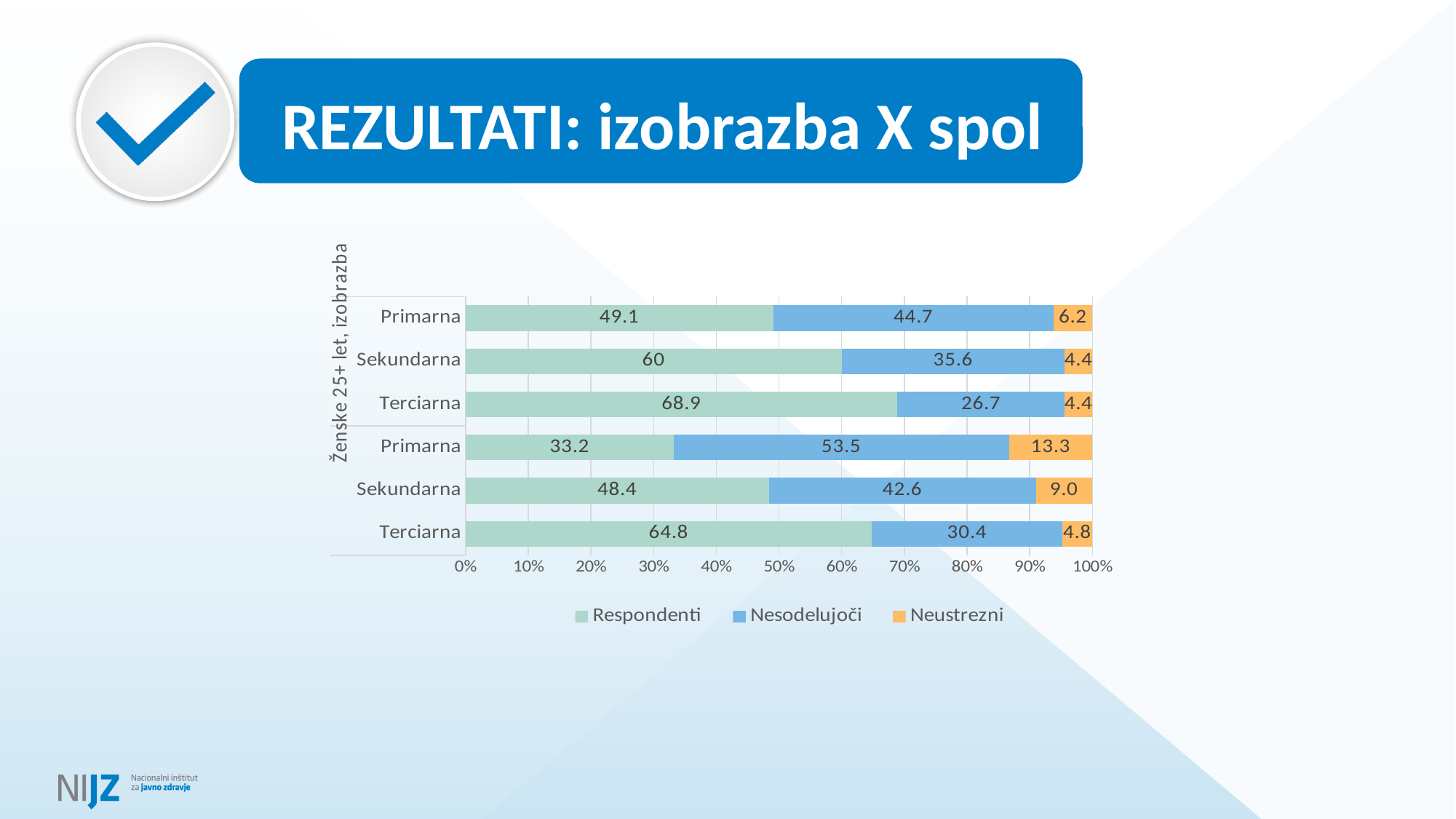
What is the Respondenti value for Terciarna in the Ženske 25+ let, izobrazba group? 68.9 How many series does the legend list? 3 Which bar has the highest Respondenti value? Terciarna (Ženske 25+ let), 68.9 What are the three legend entries of the chart? Respondenti, Nesodelujoči, Neustrezni What is the Neustrezni value for Primarna in the Ženske 25+ let, izobrazba group? 6.2 What is the Nesodelujoči value for the Primarna bar in the lower group of three bars? 53.5 How many bars are plotted in the chart? 6 In the lower group of three bars, which has the larger Neustrezni value, Primarna or Sekundarna? Primarna What is the difference between the Respondenti values for Sekundarna and Primarna in the Ženske 25+ let, izobrazba group? 10.9 What kind of chart is shown on the slide? Stacked bar chart Which bar has the highest Neustrezni value? Primarna in the lower group, 13.3 Which bar has the lowest Respondenti value? Primarna in the lower group, 33.2